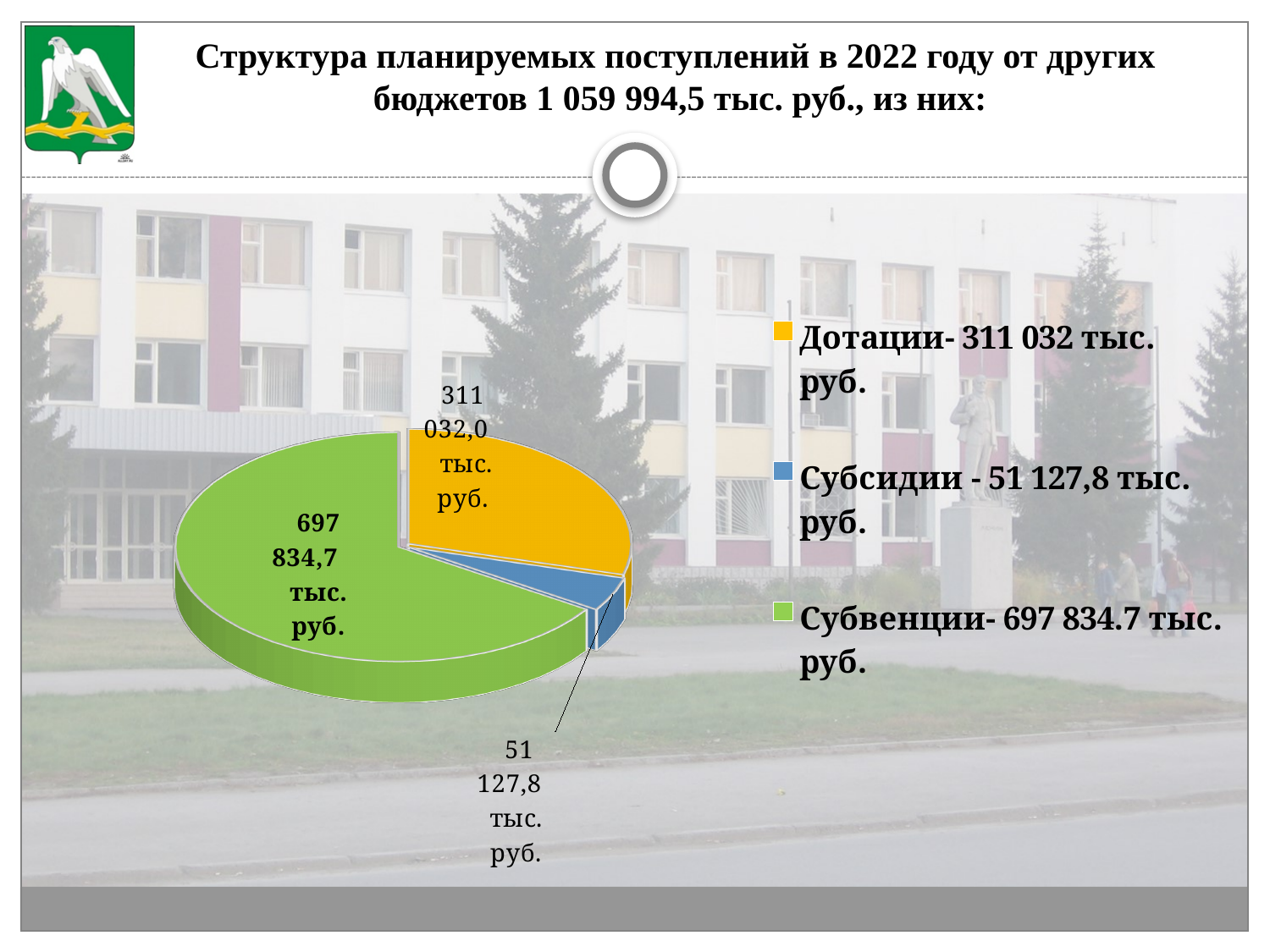
What is the difference between Субвенции and Дотации? 386 802,7 тыс. руб. How many slices does the pie chart have? 3 What is the value shown for Субсидии? 51 127,8 тыс. руб. What colour is the slice for Субсидии? Blue Which category has the smallest slice of the pie? Субсидии Which category has the largest slice of the pie? Субвенции What is the total of all three slices, as stated in the slide title? 1 059 994,5 тыс. руб. What is the value shown for Субвенции? 697 834,7 тыс. руб. How many entries does the legend list? 3 What kind of chart is shown on the slide? Pie chart What is the value shown for Дотации? 311 032,0 тыс. руб. Which is larger, Дотации or Субсидии? Дотации